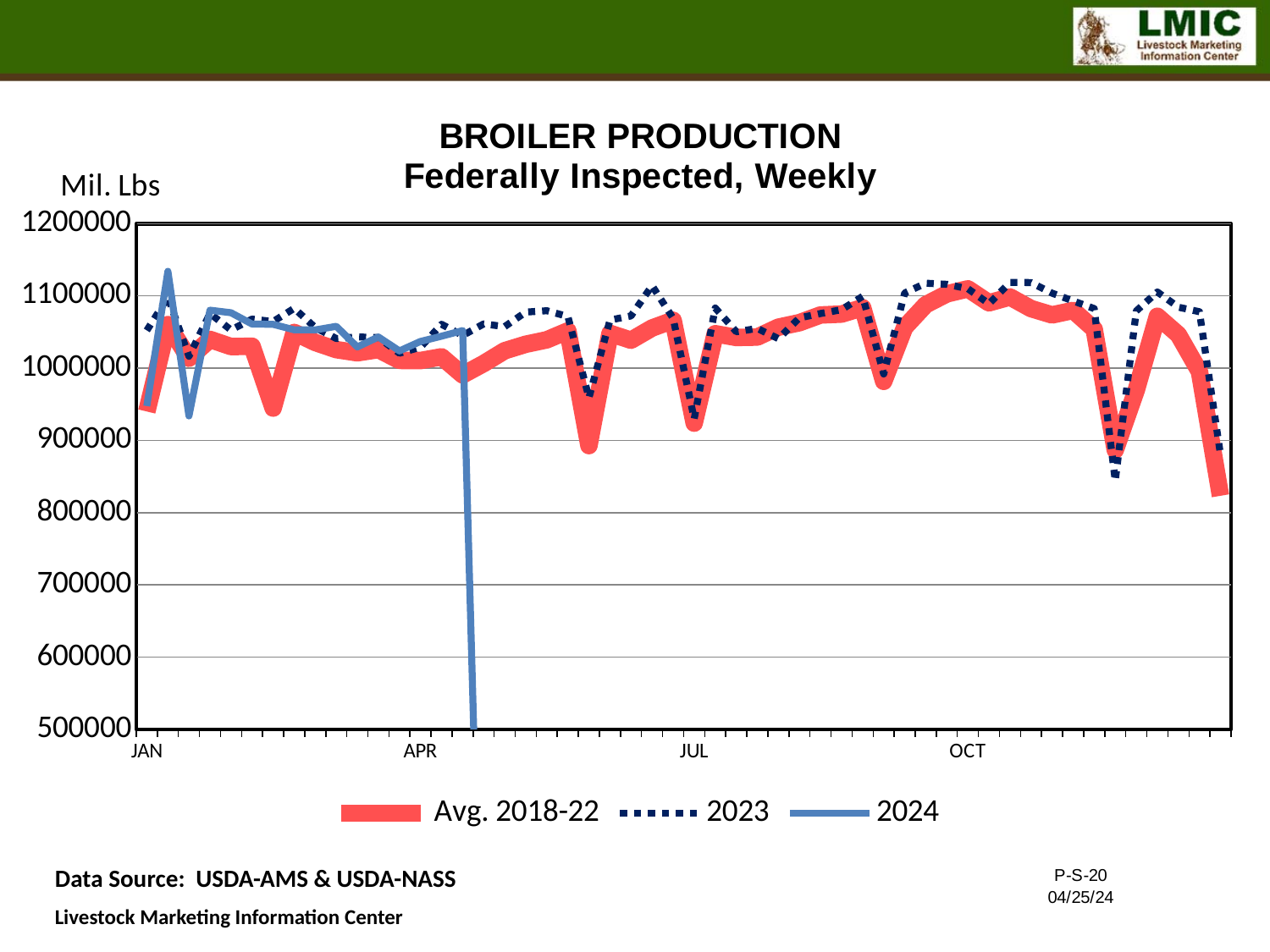
How many series does the legend list? 3 Is the peak value of the 2024 series in early January greater or less than 1100000? greater What is the title of the chart? BROILER PRODUCTION Federally Inspected, Weekly What is the highest value shown on the y axis? 1200000 Is the lowest value of the 2023 series in December greater or less than 900000? less What unit is shown on the y-axis label? Mil. Lbs Is the value of the Avg. 2018-22 series at the end of December greater or less than 900000? less How many month labels are shown on the x axis? 4 What kind of chart is shown on the slide? Line chart Which series reaches a higher value in early January: 2024 or Avg. 2018-22? 2024 Does the Avg. 2018-22 series rise or fall from OCT to the end of the year? fall What is the lowest value shown on the y axis? 500000